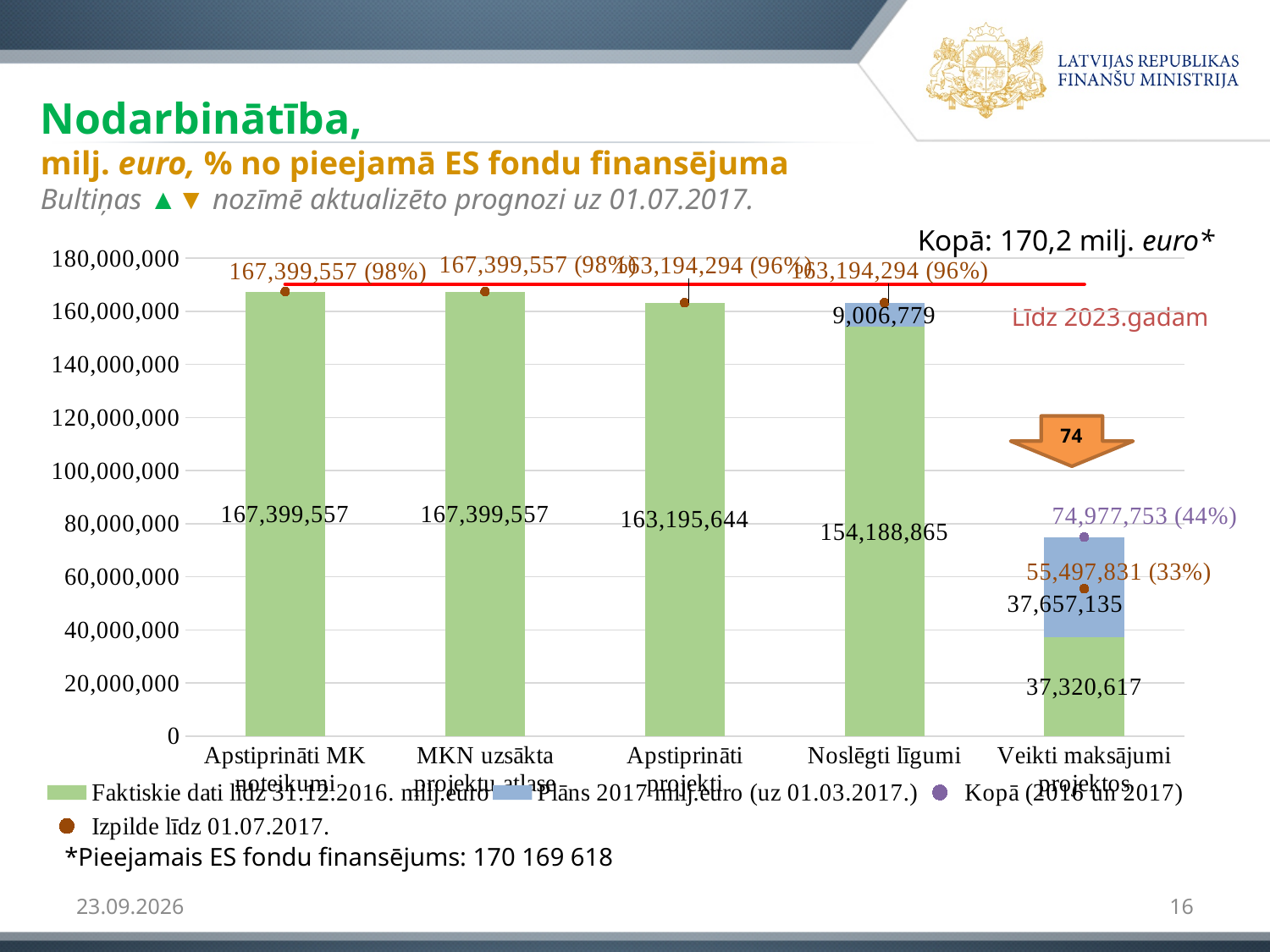
What is the difference between the 'Faktiskie dati līdz 31.12.2016.' values for 'Apstiprināti projekti' and 'Noslēgti līgumi'? 9,006,779 What is the 'Izpilde līdz 01.07.2017.' value shown for 'Veikti maksājumi projektos'? 55,497,831 (33%) What is the 'Plāns 2017' value for 'Noslēgti līgumi'? 9,006,779 What is the 'Kopā (2016 un 2017)' value shown for 'Veikti maksājumi projektos'? 74,977,753 (44%) Which is larger: the 'Faktiskie dati līdz 31.12.2016.' value for 'Noslēgti līgumi' or for 'Veikti maksājumi projektos'? Noslēgti līgumi What is the value of the 'Faktiskie dati līdz 31.12.2016.' series for 'Apstiprināti projekti'? 163,195,644 How many categories are shown on the x axis of the chart? 5 How many series does the chart legend list? 4 What type of chart is shown on the slide? combination stacked bar and line chart Is the 'Faktiskie dati līdz 31.12.2016.' value for 'Veikti maksājumi projektos' greater or less than 40,000,000? less What is the total of the stacked bar for 'Noslēgti līgumi' (Faktiskie dati plus Plāns 2017)? 163,195,644 Which category has the lowest 'Faktiskie dati līdz 31.12.2016.' value? Veikti maksājumi projektos